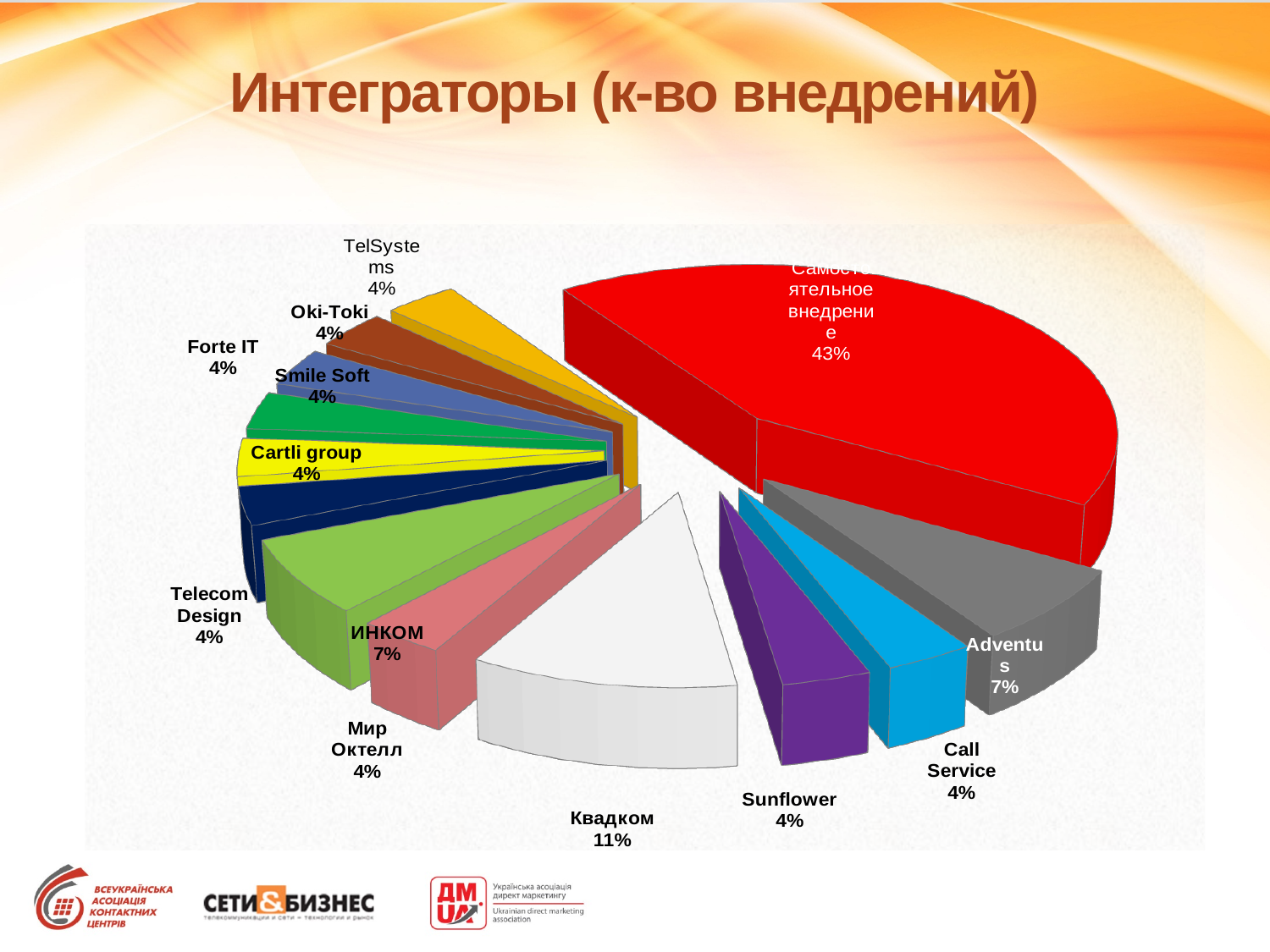
What percentage is shown for ИНКОМ? 7% What is the difference in percentage points between ИНКОМ and Мир Октелл? 3 What share of the pie does Самостоятельное внедрение have? 43% Which category has the largest slice of the pie? Самостоятельное внедрение What percentage is shown for Sunflower? 4% Which is larger, the share for Квадком or the share for Adventus? Квадком What kind of chart is shown on the slide? pie chart How many slices does the pie chart have? 13 What percentage is shown for Квадком? 11% What is the difference in percentage points between Самостоятельное внедрение and Квадком? 32 What percentage is shown for Adventus? 7% What is the title of the slide? Интеграторы (к-во внедрений)